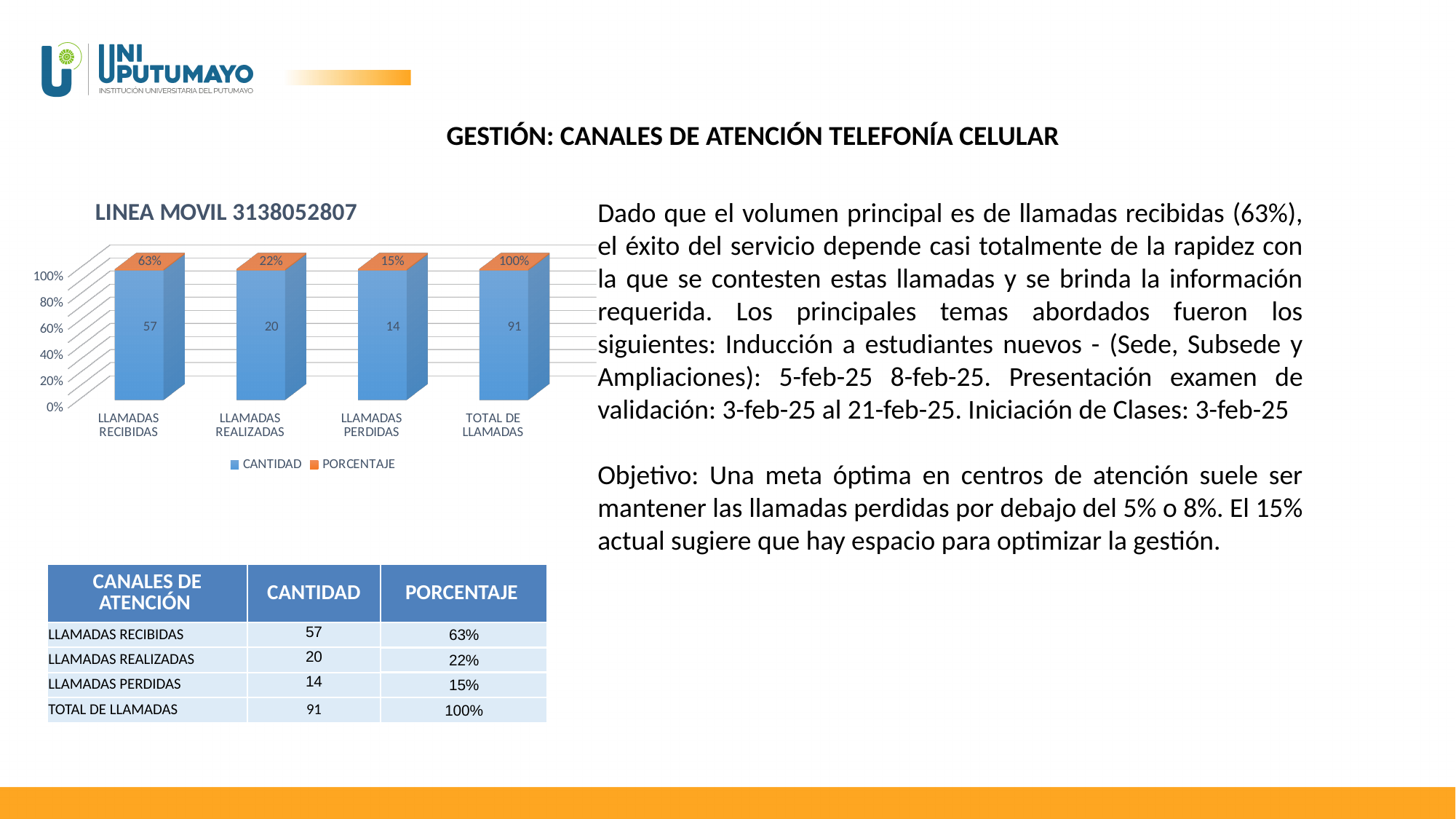
Excluding TOTAL DE LLAMADAS, which category has the highest CANTIDAD value? LLAMADAS RECIBIDAS What is the PORCENTAJE value for TOTAL DE LLAMADAS? 100% How many series does the chart legend list? 2 Which is larger, the CANTIDAD value for LLAMADAS REALIZADAS or for LLAMADAS PERDIDAS? LLAMADAS REALIZADAS What type of chart is shown on the slide? Bar chart What is the title of the chart? LINEA MOVIL 3138052807 What is the CANTIDAD value for LLAMADAS RECIBIDAS? 57 Excluding TOTAL DE LLAMADAS, which category has the lowest CANTIDAD value? LLAMADAS PERDIDAS What is the difference between the CANTIDAD values for LLAMADAS RECIBIDAS and LLAMADAS REALIZADAS? 37 What is the PORCENTAJE value for LLAMADAS PERDIDAS? 15% How many categories are shown on the x axis of the chart? 4 What is the CANTIDAD value for LLAMADAS REALIZADAS? 20